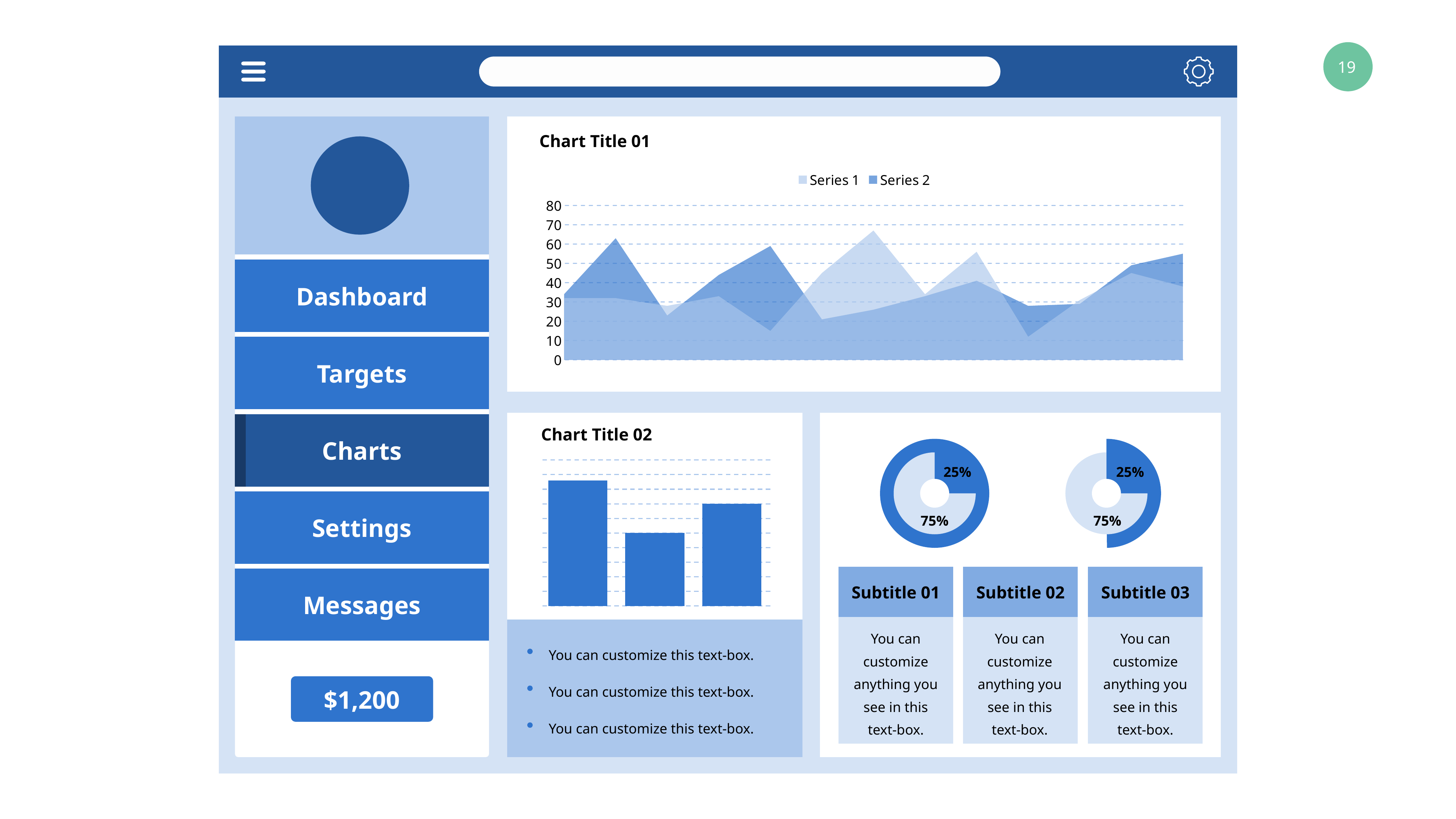
In the left doughnut chart on the right-hand panel, what share does the larger slice represent? 75% How many doughnut charts are shown on the slide? 2 In Chart Title 02, which bar is the shortest? The middle (second) bar What is the highest value shown on the y axis of Chart Title 01? 80 What are the legend entries in Chart Title 01? Series 1 and Series 2 What kind of chart is Chart Title 02? Bar chart How many series does the legend of Chart Title 01 list? 2 In the right doughnut chart on the right-hand panel, what share does the smaller slice represent? 25% How many bars are plotted in Chart Title 02? 3 What kind of chart is Chart Title 01? Area chart In Chart Title 02, is the left bar or the right bar taller? The left bar In Chart Title 02, which bar is the tallest? The left (first) bar